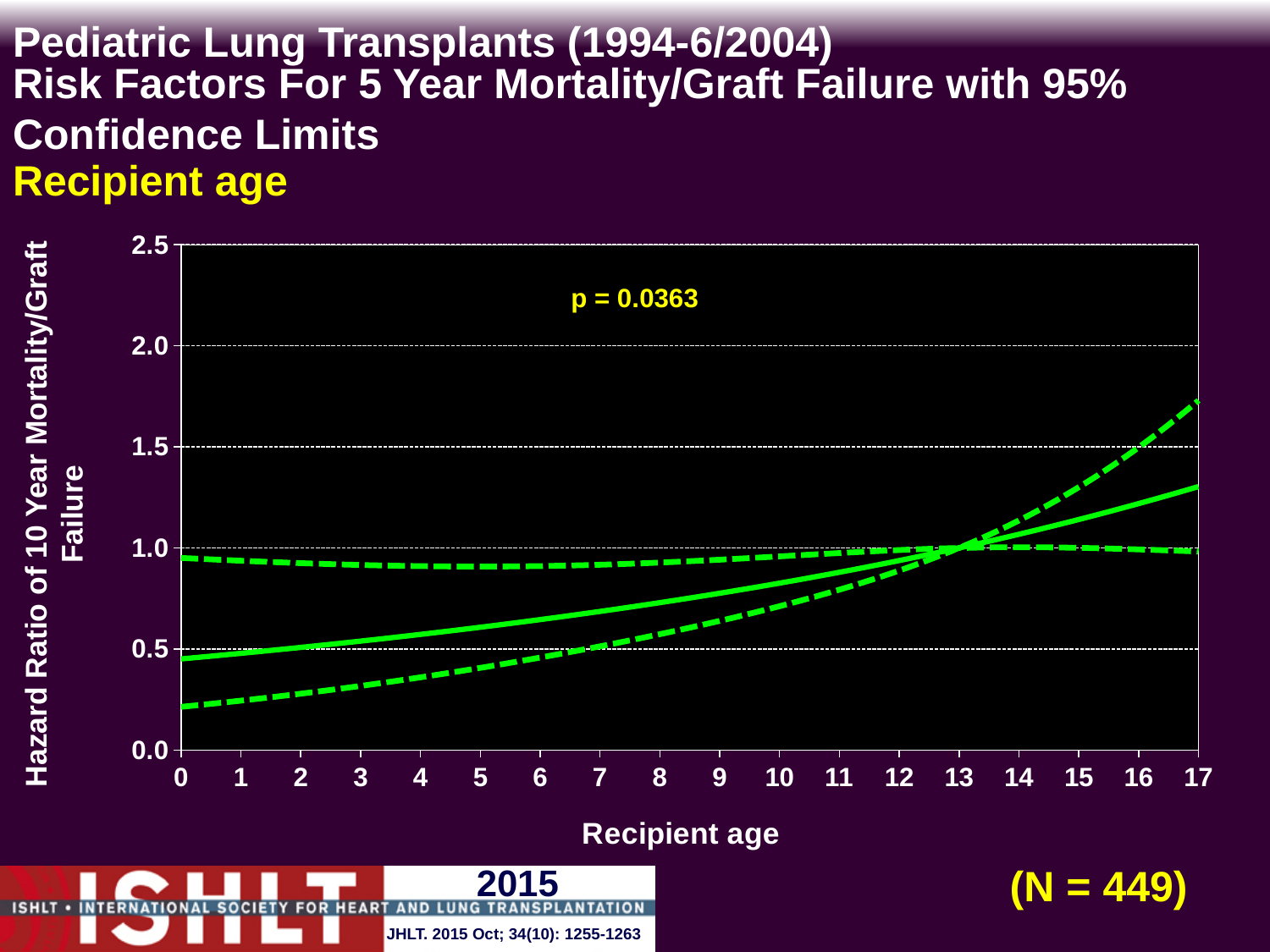
What p-value is printed on the chart? p = 0.0363 What kind of chart is shown on the slide? line chart Is the upper dashed confidence limit at recipient age 5 greater or less than 1.0? less Is the lower dashed confidence limit at recipient age 0 greater or less than 0.5? less Is the lower dashed confidence limit at recipient age 10 greater or less than 0.5? greater What sample size (N) is shown on the slide? N = 449 Does the solid hazard ratio line rise or fall as recipient age increases from 0 to 17? rise How many recipient age tick marks are labelled on the x axis? 18